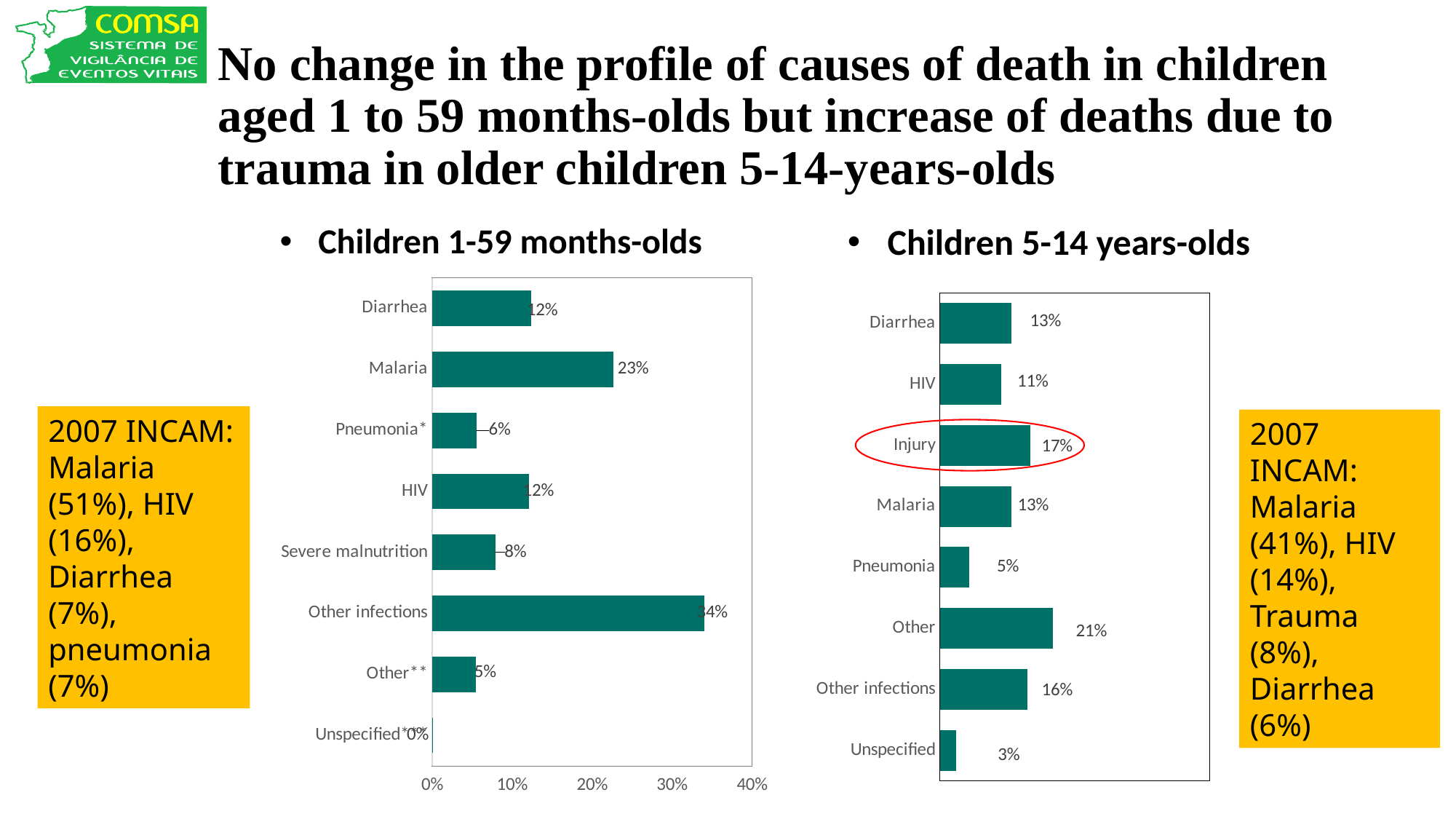
In the Children 5-14 years-olds chart, which category has the lowest value? Unspecified In the Children 1-59 months-olds chart, what is the difference between Other infections and Malaria? 11% In the Children 1-59 months-olds chart, how many categories are shown? 8 In the Children 5-14 years-olds chart, what is the difference between Other and Pneumonia? 16% In the Children 1-59 months-olds chart, what is the value for Malaria? 23% In the Children 5-14 years-olds chart, what is the value for Injury? 17% In the Children 5-14 years-olds chart, which category has the highest value? Other What type of chart is the Children 5-14 years-olds chart? Bar chart In the Children 1-59 months-olds chart, is the value for Severe malnutrition greater or less than 10%? less In the Children 5-14 years-olds chart, which is larger, Injury or Other infections? Injury In the Children 1-59 months-olds chart, which category has the lowest value? Unspecified*** In the Children 1-59 months-olds chart, which category has the highest value? Other infections